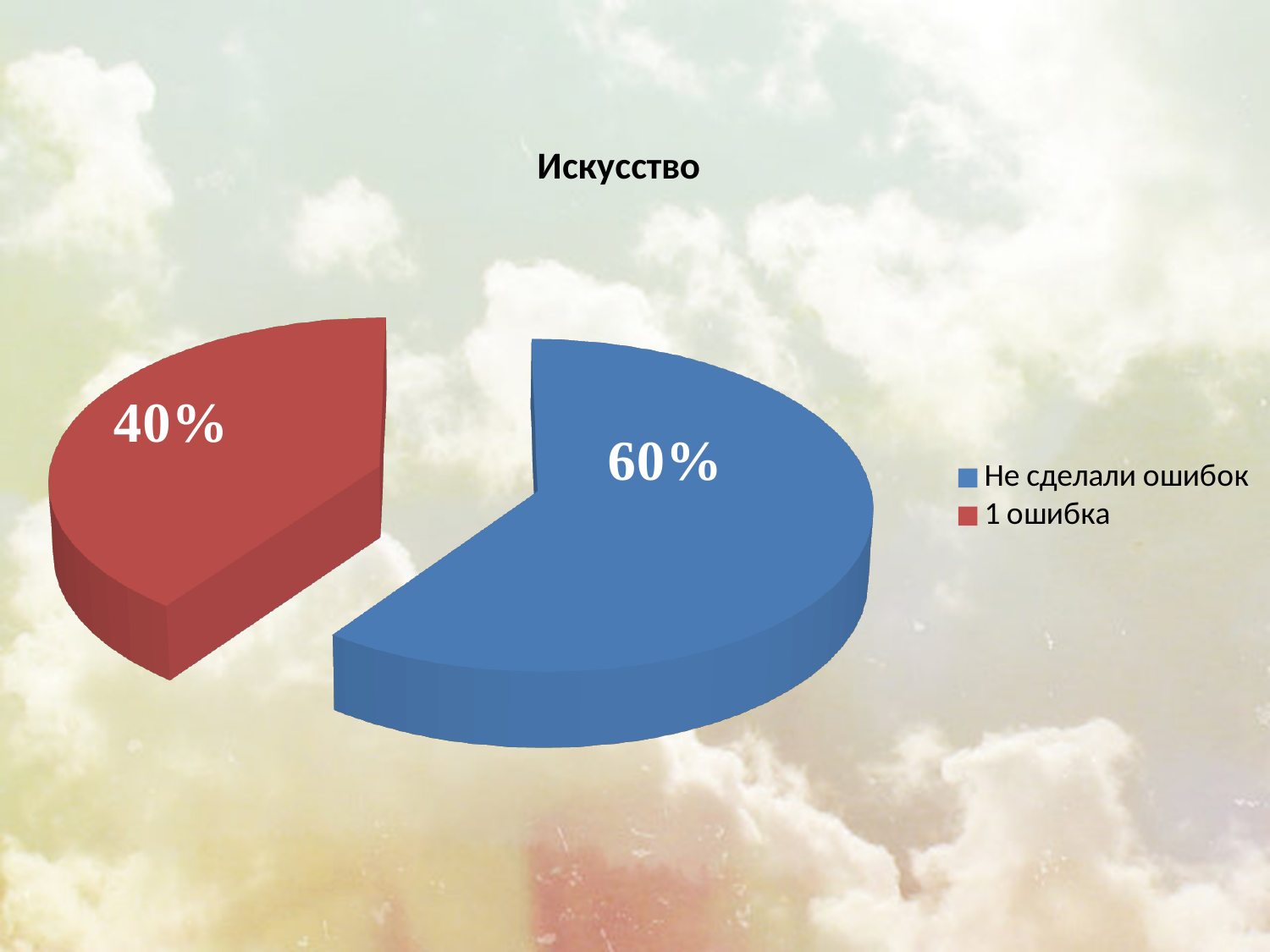
How many slices does the pie chart have? 2 What is the difference in percentage points between "Не сделали ошибок" and "1 ошибка"? 20% What share of the pie does "Не сделали ошибок" take? 60% What share of the pie does "1 ошибка" take? 40% What colour is the slice for "1 ошибка"? red What kind of chart is shown on the slide? pie chart What is the title of the chart? Искусство Which category has the largest slice of the pie? Не сделали ошибок How many entries does the legend list? 2 Which is larger: the slice for "Не сделали ошибок" or the slice for "1 ошибка"? Не сделали ошибок Which category has the smallest slice of the pie? 1 ошибка